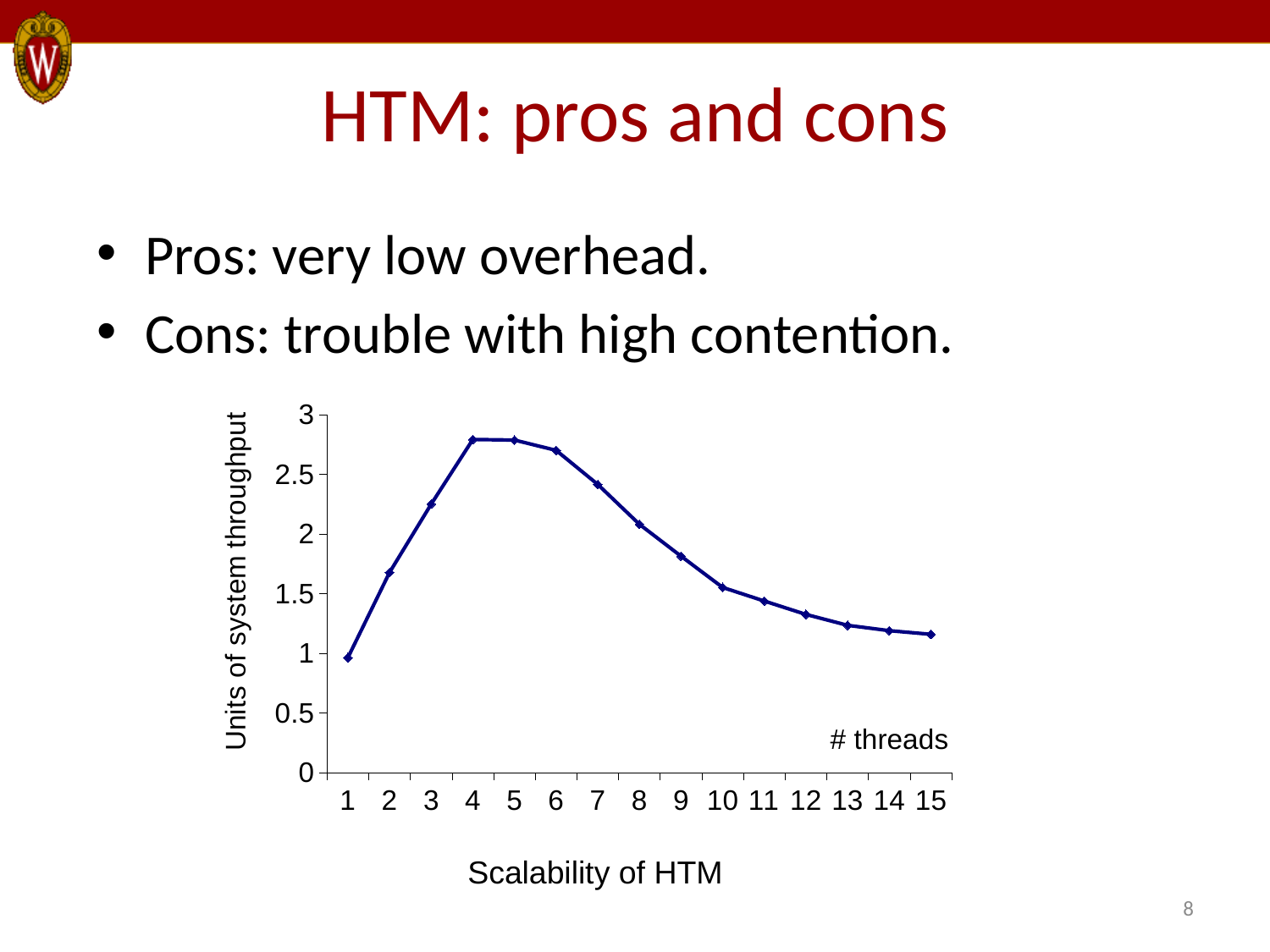
Is the value at 12 threads greater or less than 1.5? less Is the value at 7 threads greater or less than 2.5? less Is the value at 3 threads greater or less than 2? greater What is the title of the chart? Scalability of HTM Which has the higher throughput, 3 threads or 9 threads? 3 threads What kind of chart is shown on the slide? line chart How many data points are plotted on the line? 15 At which number of threads is the throughput lowest? 1 What is the label of the vertical axis? Units of system throughput How does the throughput change as the number of threads increases from 6 to 15? it falls